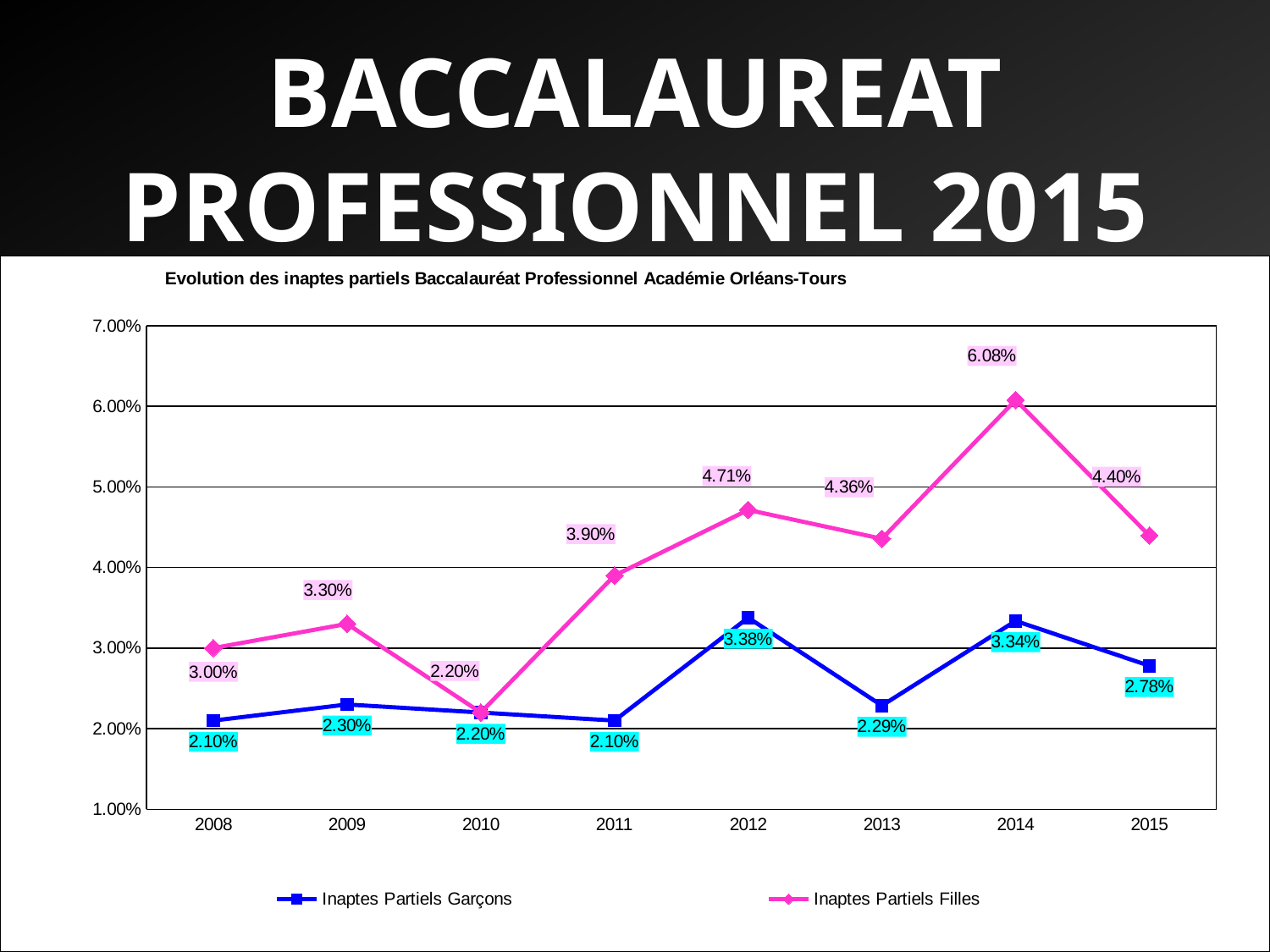
In which year is the Inaptes Partiels Filles value lowest? 2010 What is the title of the chart? Evolution des inaptes partiels Baccalauréat Professionnel Académie Orléans-Tours Which series has the larger value in 2013, Inaptes Partiels Garçons or Inaptes Partiels Filles? Inaptes Partiels Filles What is the value for Inaptes Partiels Filles in 2011? 3.90% What is the value for Inaptes Partiels Garçons in 2012? 3.38% What type of chart is shown on the slide? Line chart Does the Inaptes Partiels Filles value rise or fall from 2014 to 2015? Fall In which year is the Inaptes Partiels Filles value highest? 2014 How many years are plotted on the x axis? 8 What is the difference between the Inaptes Partiels Filles and Inaptes Partiels Garçons values in 2014? 2.74% How many series does the legend list? 2 What is the value for Inaptes Partiels Filles in 2014? 6.08%